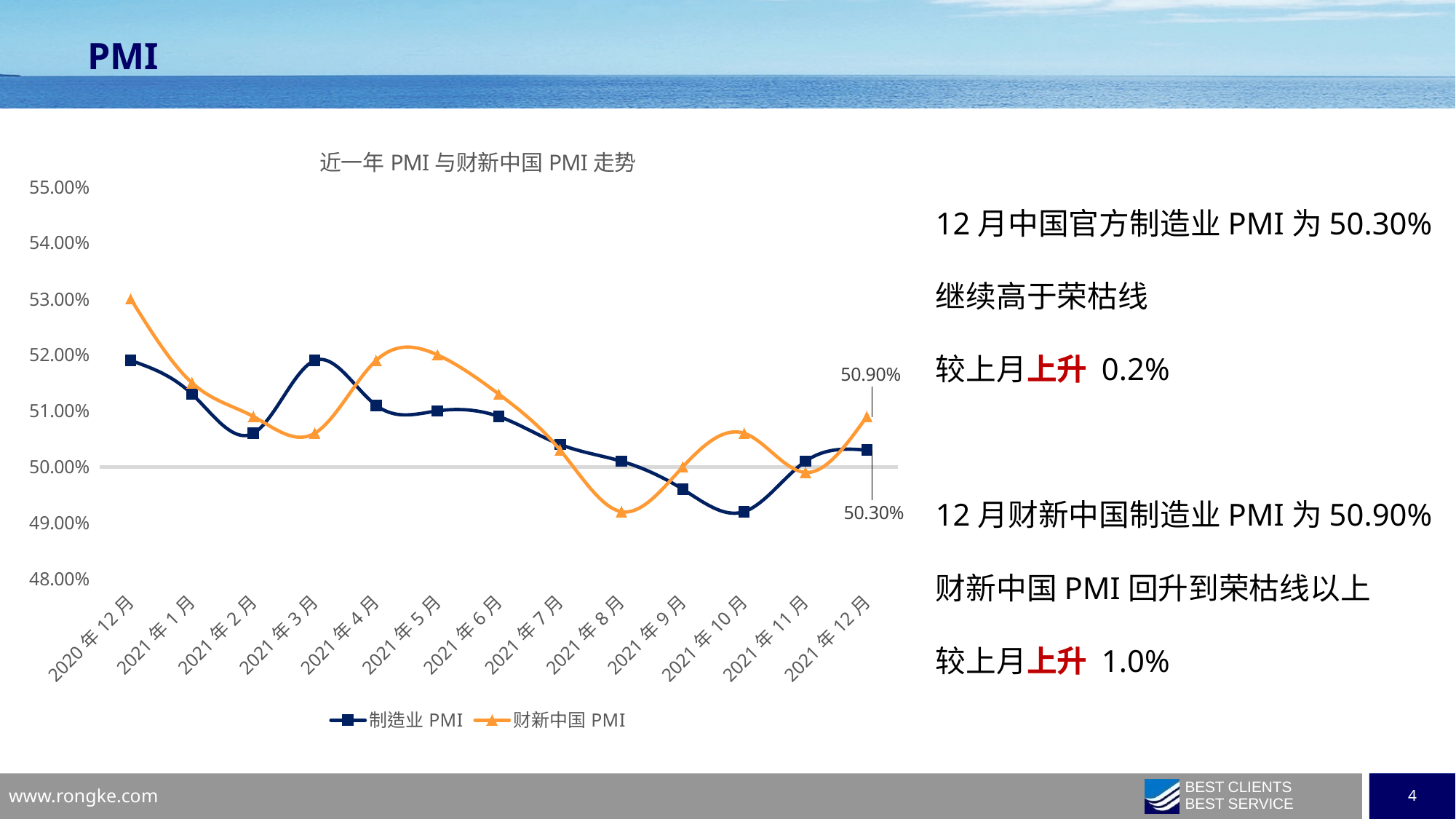
In 2021年12月, which series is higher: 制造业 PMI or 财新中国 PMI? 财新中国 PMI What is the difference between 财新中国 PMI and 制造业 PMI in 2021年12月? 0.60% How many months are plotted on the x axis? 13 What kind of chart is shown on the slide? line chart Which month has the lowest 制造业 PMI value? 2021年10月 Is the value of 财新中国 PMI for 2020年12月 greater or less than 52.00%? greater What is the value of 财新中国 PMI for 2021年12月? 50.90% Is the value of 制造业 PMI for 2021年10月 greater or less than 50.00%? less What is the value of 制造业 PMI for 2021年12月? 50.30% Which month has the highest 财新中国 PMI value? 2020年12月 How many series does the legend list? 2 What is the title of the chart? 近一年 PMI 与财新中国 PMI 走势